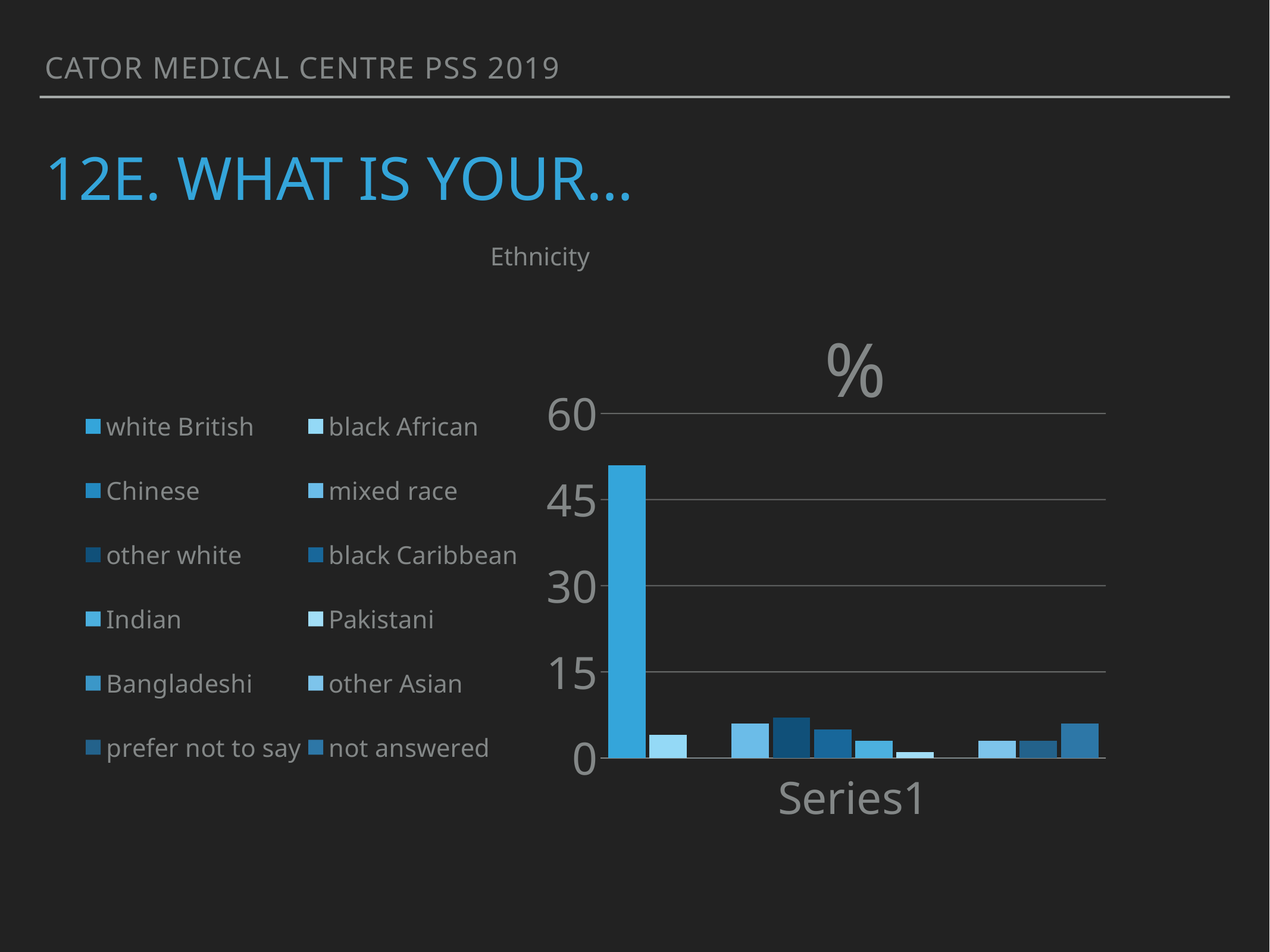
Which is larger, the value for white British or the value for black African? white British What kind of chart is shown on the slide? bar chart Is the value for white British greater or less than 60? less How many categories are shown on the x axis? 1 Which series has the highest value? white British How many series does the legend list? 12 What is the title of the chart? % Is the value for black African greater or less than 15? less Is the value for white British greater or less than 45? greater